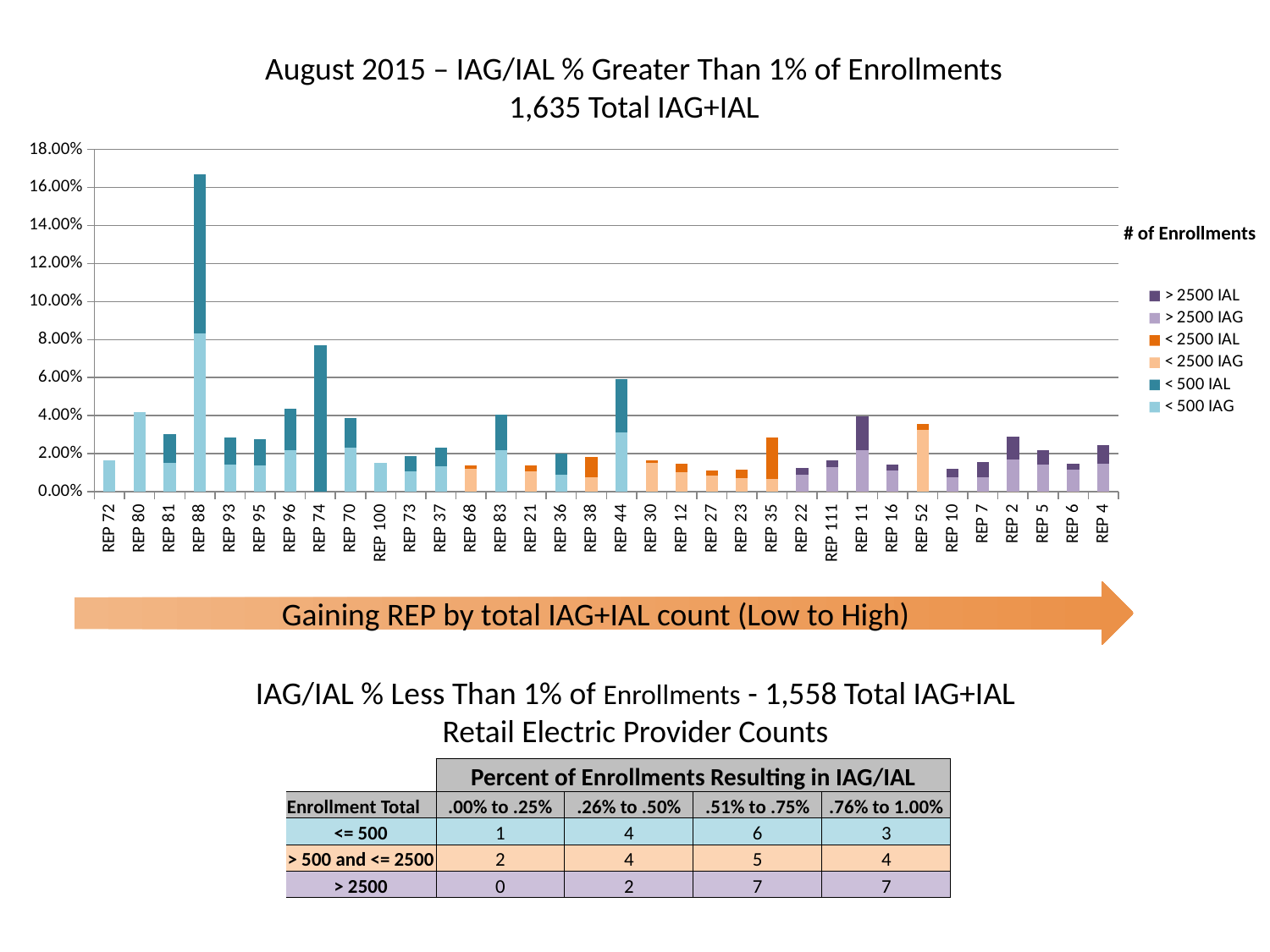
Is the total value for REP 88 greater or less than 14.00%? greater What kind of chart is shown on the slide? Stacked bar chart Is the total value for REP 74 greater or less than 6.00%? greater Is the total value for REP 44 greater or less than 4.00%? greater Which has the larger total bar, REP 80 or REP 81? REP 80 Which has the larger total bar, REP 88 or REP 74? REP 88 What is the title of the chart? August 2015 – IAG/IAL % Greater Than 1% of Enrollments 1,635 Total IAG+IAL What heading appears above the chart's legend? # of Enrollments How many REP categories are plotted along the x axis of the chart? 34 Which REP has the highest total bar in the chart? REP 88 How many series does the chart's legend list? 6